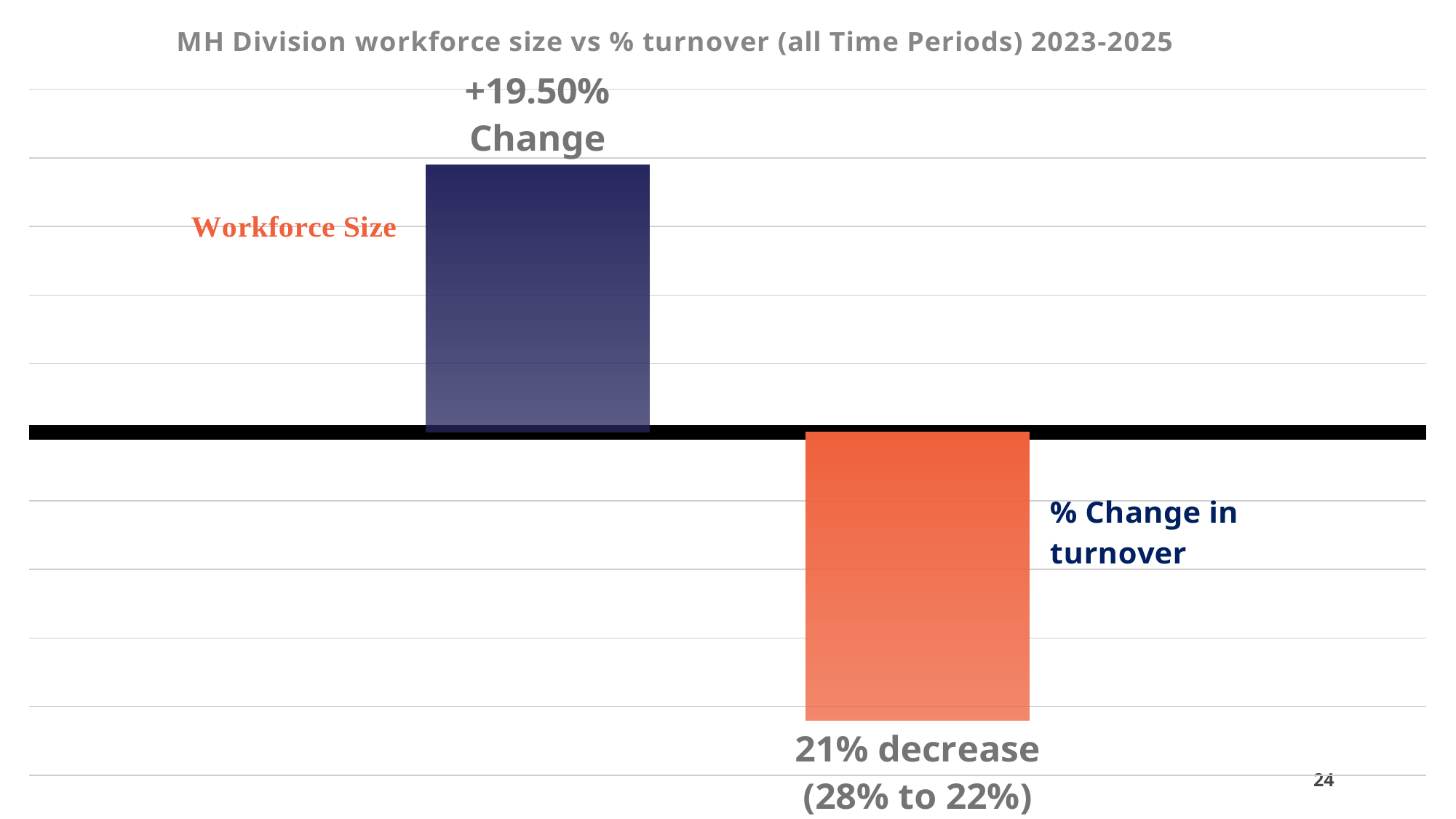
Which bar extends below the horizontal baseline? % Change in turnover Is the Workforce Size change positive or negative? positive Which bar extends above the horizontal baseline, Workforce Size or % Change in turnover? Workforce Size What colour is the Workforce Size bar? dark blue/navy Is the % Change in turnover positive or negative? negative What is the title of the chart? MH Division workforce size vs % turnover (all Time Periods) 2023-2025 According to the data label, what did turnover change from and to? 28% to 22% What is the labelled change for Workforce Size? +19.50% What is the labelled change in turnover? 21% decrease What is the turnover percentage at the end of the period, according to the data label? 22% How many bars are plotted in the chart? 2 What kind of chart is shown on the slide? bar chart